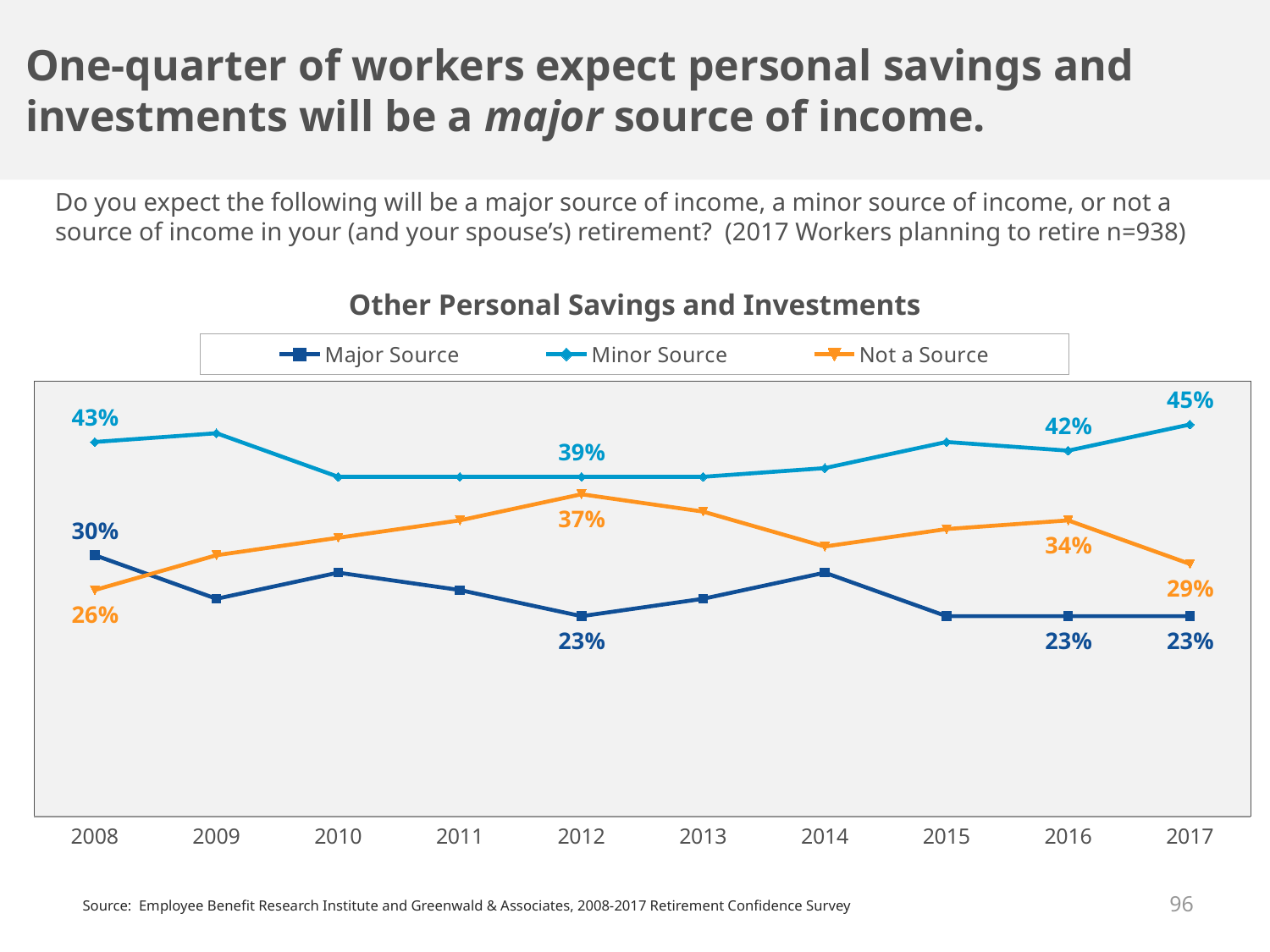
Which series has the highest value in 2017? Minor Source Which is larger in 2008: Major Source or Not a Source? Major Source What is the difference between Minor Source and Major Source in 2017? 22 percentage points What is the value for Not a Source in 2012? 37% What is the value for Major Source in 2008? 30% What is the value for Not a Source in 2016? 34% What is the value for Minor Source in 2017? 45% How many years are shown on the x axis? 10 What is the difference between Not a Source in 2016 and Not a Source in 2017? 5 percentage points How many series does the legend list? 3 What is the title of the chart? Other Personal Savings and Investments What type of chart is shown on the slide? Line chart